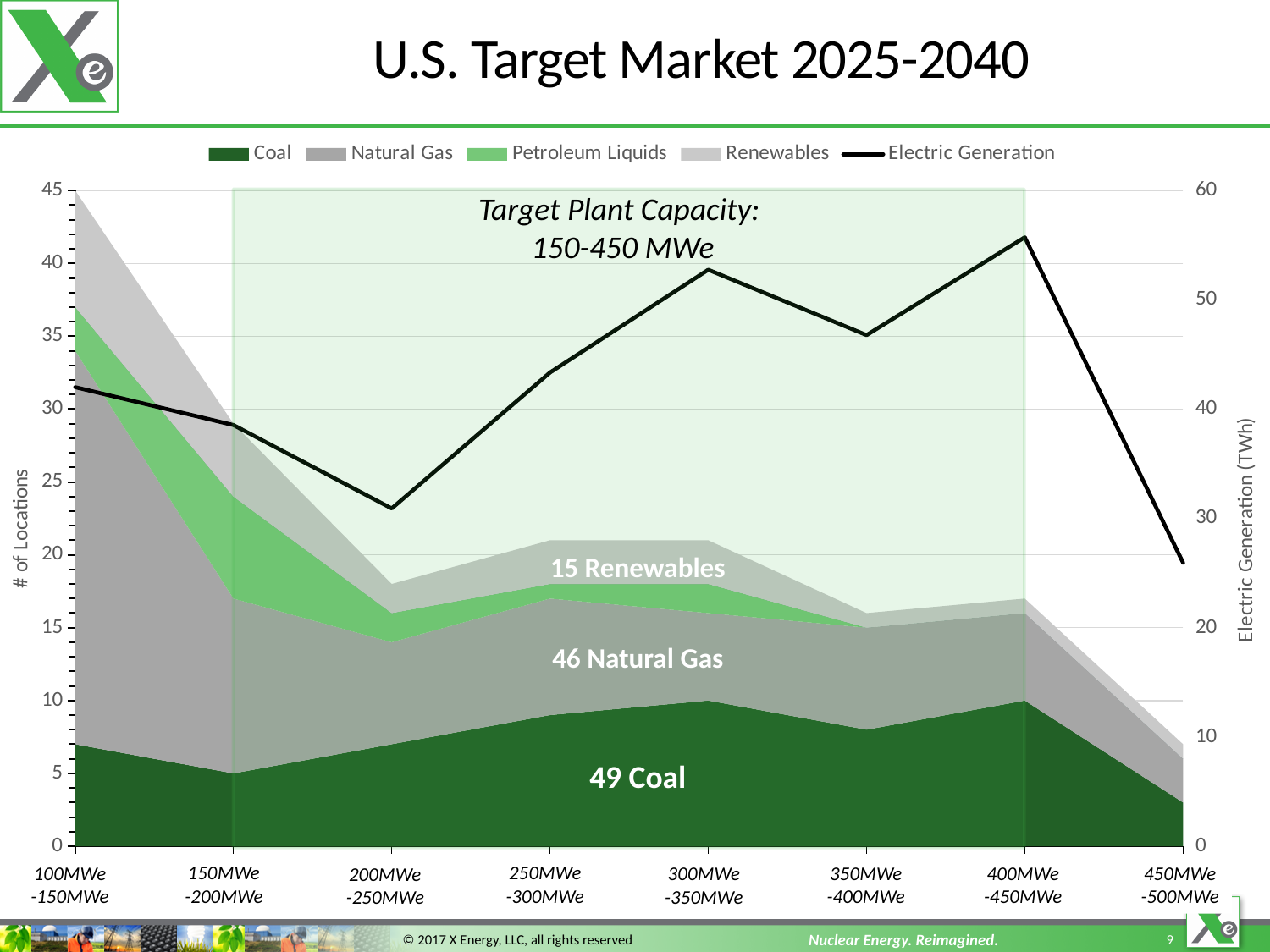
What is the label of the right-hand vertical axis? Electric Generation (TWh) Is the Coal value for 450MWe-500MWe greater or less than 5 locations? less Is the Electric Generation value for 400MWe-450MWe greater or less than 50 TWh? greater Is the Electric Generation value for 200MWe-250MWe greater or less than 40 TWh? less What kind of chart is shown on the slide? stacked area chart with a line Does the Electric Generation line rise or fall from 200MWe-250MWe to 300MWe-350MWe? rise Which capacity category has the highest Electric Generation value? 400MWe-450MWe How many series does the legend list? 5 How many capacity categories are shown along the x axis? 8 What target plant capacity range is annotated on the chart? 150-450 MWe Which is larger, the Electric Generation value for 300MWe-350MWe or for 350MWe-400MWe? 300MWe-350MWe Which capacity category has the lowest Electric Generation value? 450MWe-500MWe